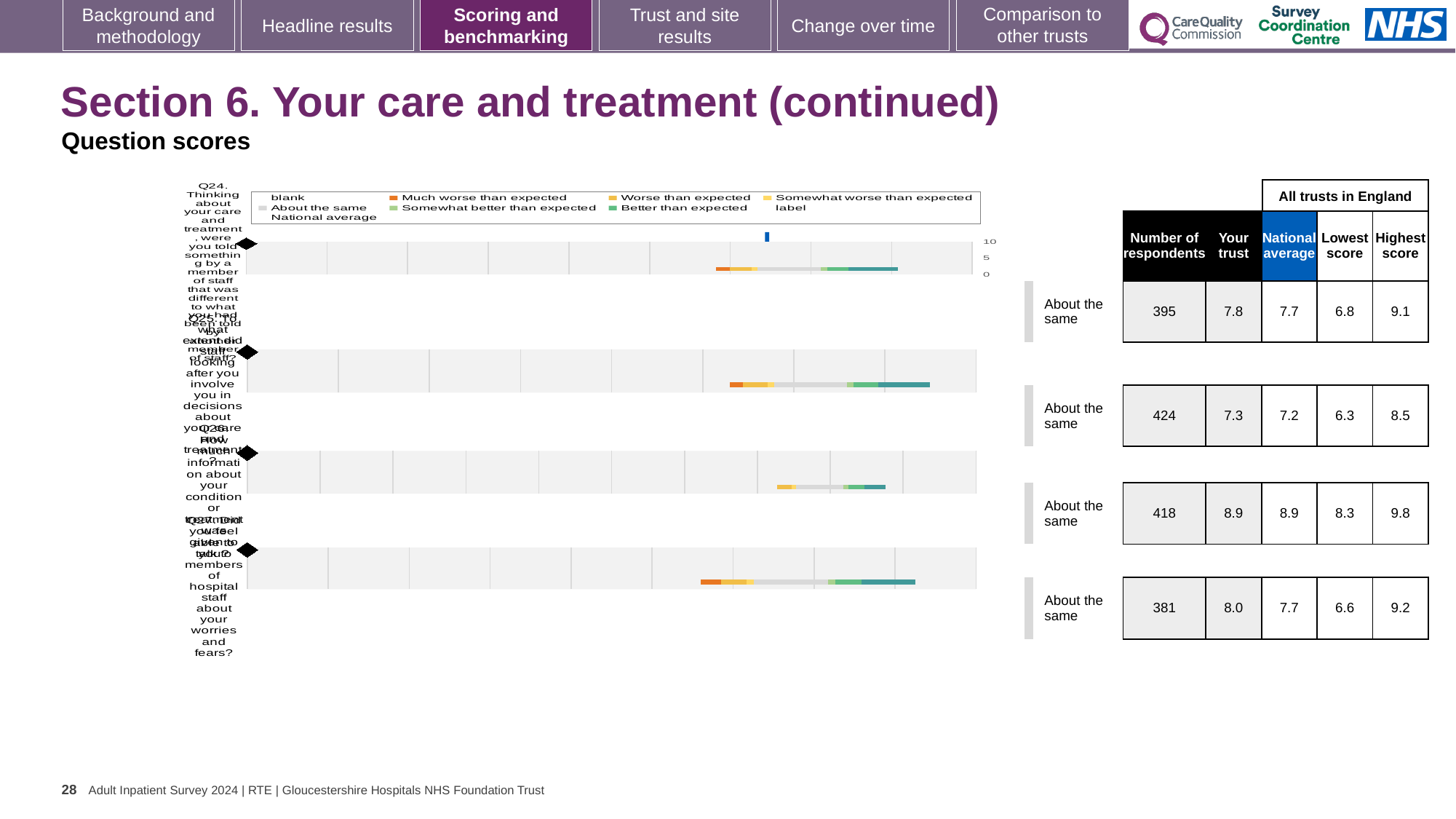
How many respondents are shown for the first row (Q24) in the table? 395 What is the highest score across all trusts in England for the second row (Q25)? 8.5 Which question row has the highest 'Your trust' score? Q26 For the fourth row (Q27), what is the difference between the 'Your trust' score and the national average? 0.3 Which question row has the lowest 'Your trust' score? Q25 For the third row (Q26), what is the difference between the highest score and the lowest score? 1.5 What kind of chart is used to show the question scores? Bar chart What is the 'Your trust' score for the third row (Q26)? 8.9 What benchmark category is shown for every question row on this slide? About the same What is the lowest score across all trusts in England for the fourth row (Q27)? 6.6 For the first row (Q24), is the 'Your trust' score or the national average larger? Your trust How many question rows are plotted on the chart? 4